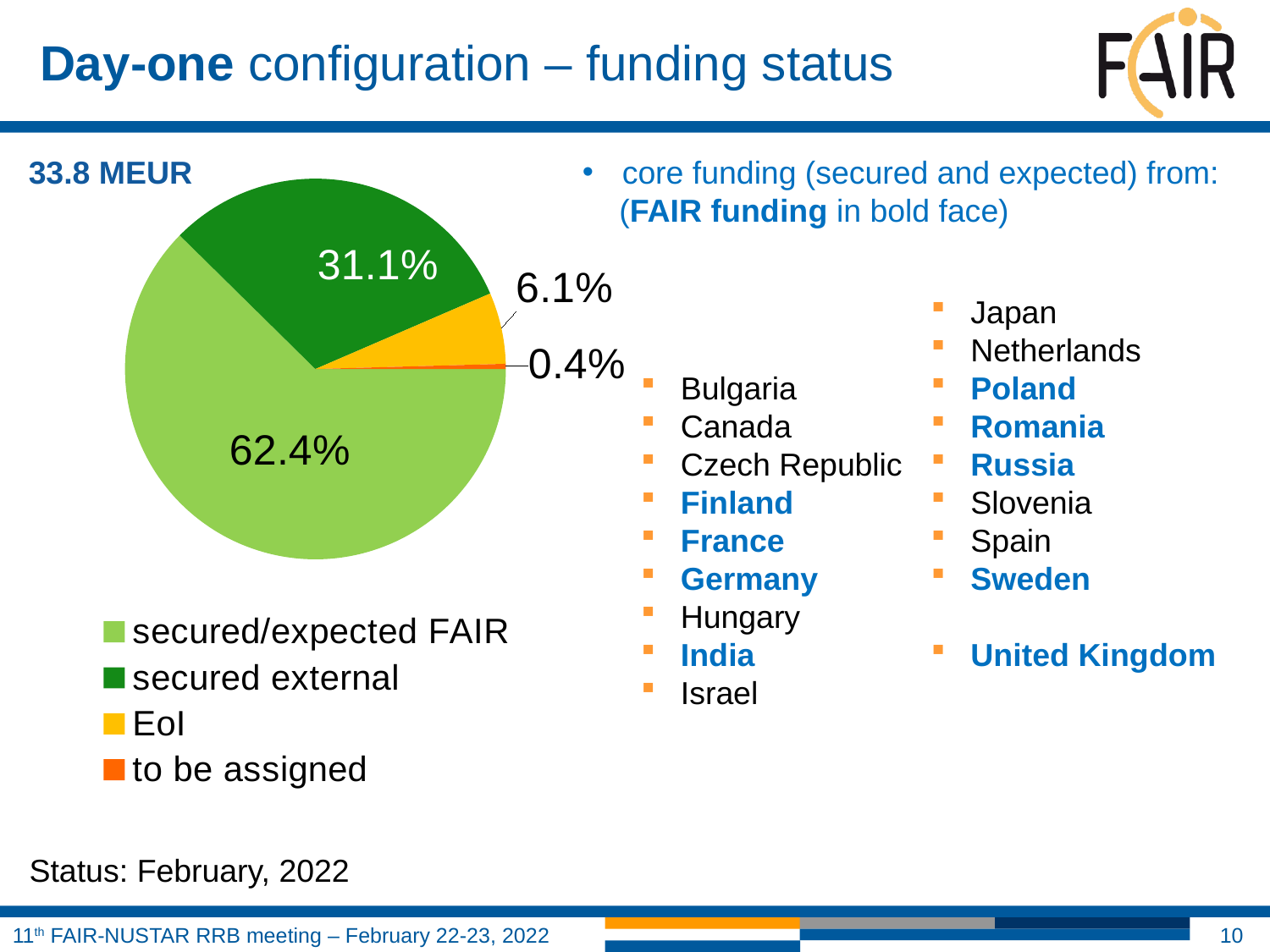
How many slices does the pie chart have? 4 Which slice of the pie is the largest? secured/expected FAIR Which slice of the pie is the smallest? to be assigned What colour is the EoI slice in the pie chart? yellow What share of the pie is secured external? 31.1% What share of the pie is to be assigned? 0.4% What is the difference in percentage points between secured/expected FAIR and secured external? 31.3 What share of the pie is secured/expected FAIR? 62.4% What kind of chart is shown on the slide? pie chart What total amount in MEUR is shown above the pie chart? 33.8 MEUR Which is larger, the EoI slice or the secured external slice? secured external